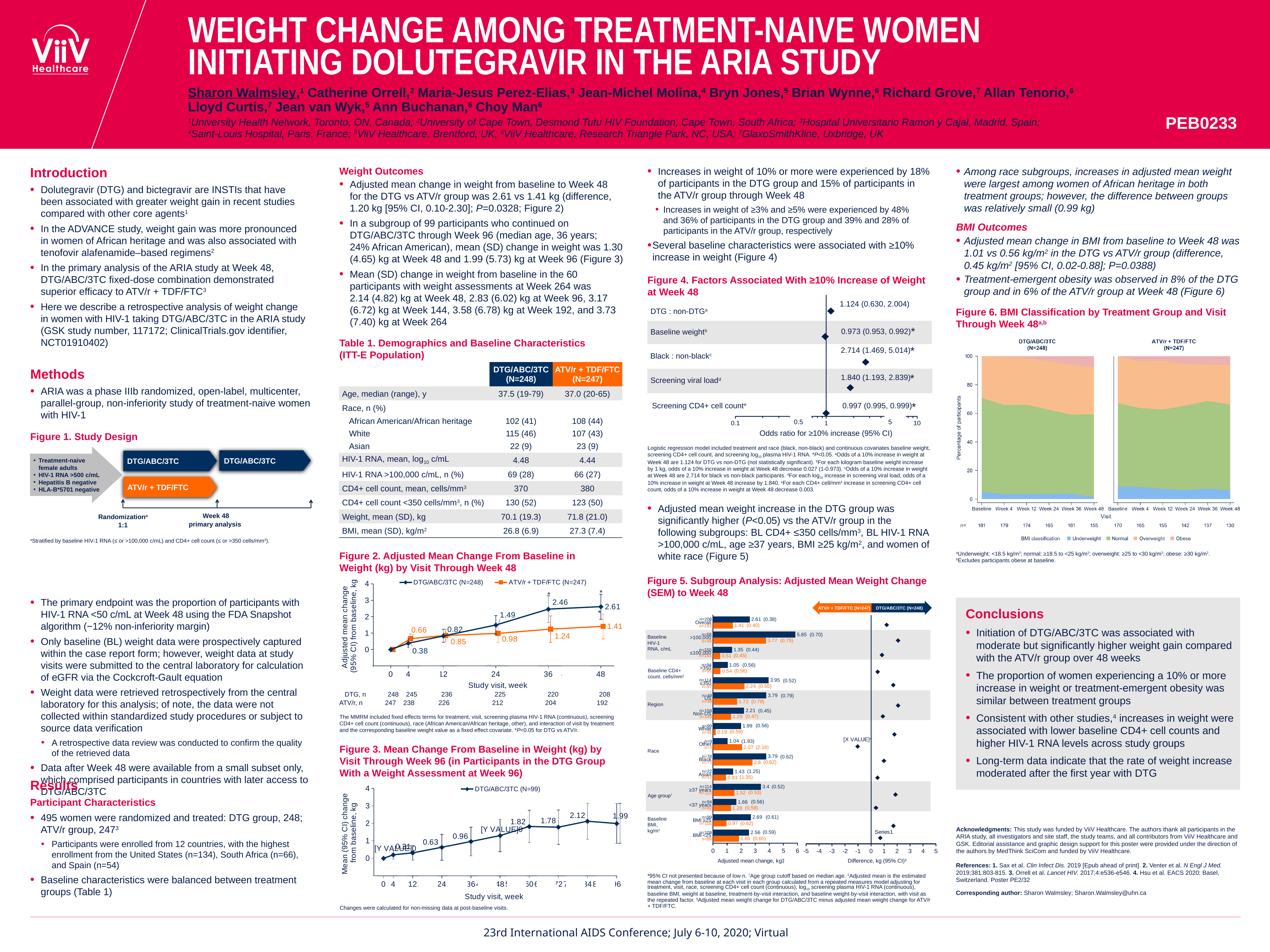
In Figure 2 (Adjusted Mean Change From Baseline in Weight by Visit Through Week 48), how many series does the legend list? 2 In Figure 2 (Adjusted Mean Change From Baseline in Weight by Visit Through Week 48), what is the adjusted mean change for DTG/ABC/3TC at week 48? 2.61 In Figure 4 (Factors Associated With ≥10% Increase of Weight at Week 48), what is the odds ratio for Black : non-black? 2.714 (1.469, 5.014) In Figure 3 (Mean Change From Baseline in Weight by Visit Through Week 96), at which study visit is the mean change highest? Week 84 In Figure 2 (Adjusted Mean Change From Baseline in Weight by Visit Through Week 48), what is the difference between the DTG/ABC/3TC and ATV/r + TDF/FTC values at week 48? 1.20 In Figure 5 (Subgroup Analysis: Adjusted Mean Weight Change to Week 48), what is the adjusted mean change for DTG/ABC/3TC in the baseline HIV-1 RNA >100,000 c/mL subgroup? 5.85 In Figure 3 (Mean Change From Baseline in Weight by Visit Through Week 96), what kind of chart is shown? Line chart In Figure 2 (Adjusted Mean Change From Baseline in Weight by Visit Through Week 48), which treatment group has the higher value at week 4? ATV/r + TDF/FTC In Figure 3 (Mean Change From Baseline in Weight by Visit Through Week 96), what is the mean change at week 84? 2.12 In Figure 6 (BMI Classification by Treatment Group and Visit Through Week 48), how many BMI classification categories does the legend list? 4 In Figure 4 (Factors Associated With ≥10% Increase of Weight at Week 48), how many factors are plotted? 5 In Figure 2 (Adjusted Mean Change From Baseline in Weight by Visit Through Week 48), what is the adjusted mean change for ATV/r + TDF/FTC at week 36? 1.24